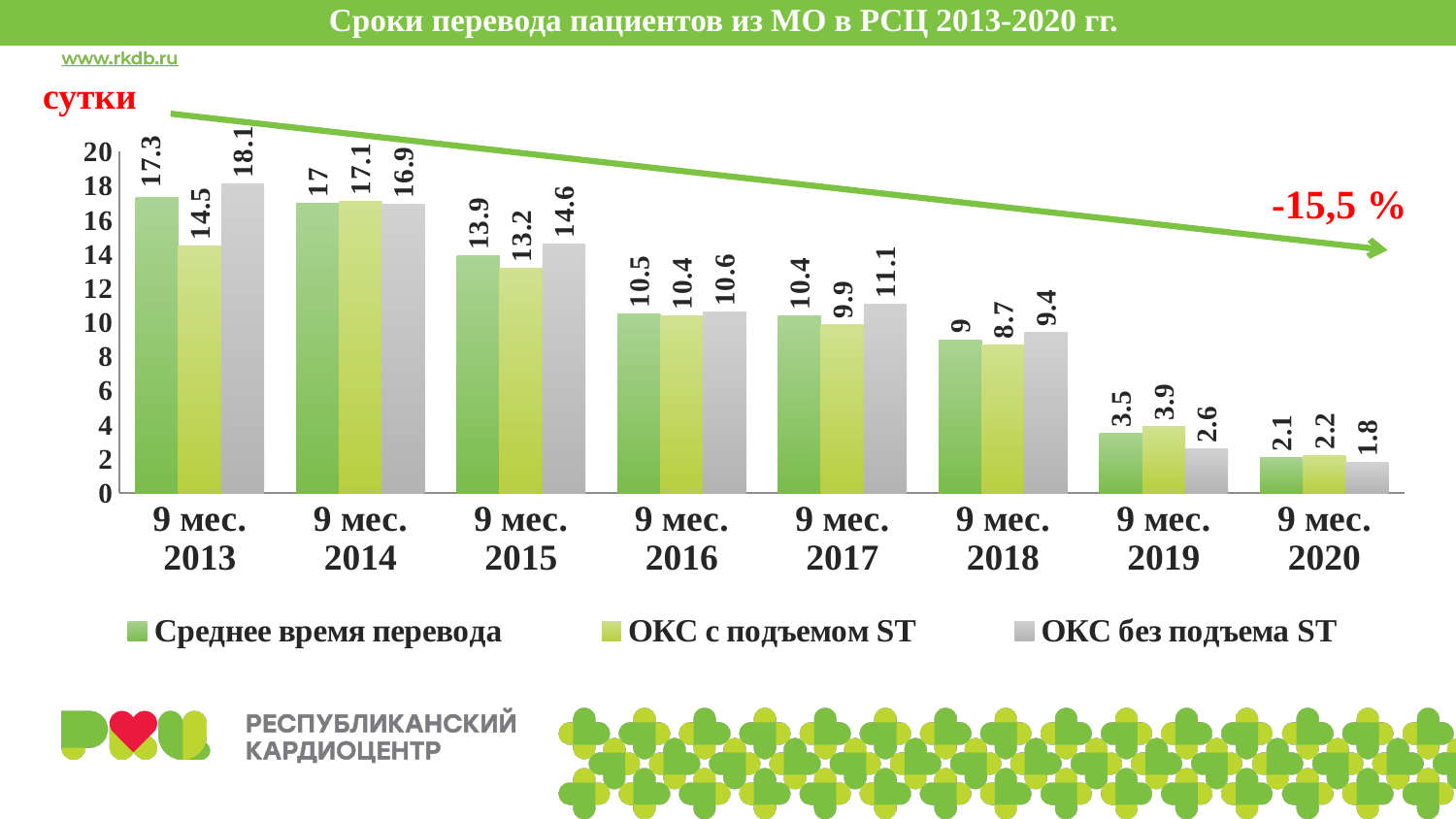
Do the values of "Среднее время перевода" rise or fall from 9 мес. 2013 to 9 мес. 2020? fall How many categories are shown on the x axis? 8 What is the value of "ОКС без подъема ST" for 9 мес. 2017? 11.1 What is the value of "ОКС с подъемом ST" for 9 мес. 2019? 3.9 What kind of chart is shown on the slide? bar chart What is the value of "Среднее время перевода" for 9 мес. 2013? 17.3 In which category is "ОКС без подъема ST" highest? 9 мес. 2013 What percentage change is printed in red next to the arrow on the chart? -15,5 % In which category is "Среднее время перевода" lowest? 9 мес. 2020 Which is larger for 9 мес. 2019: "ОКС с подъемом ST" or "ОКС без подъема ST"? ОКС с подъемом ST How many series does the legend list? 3 What is the difference between "ОКС без подъема ST" and "ОКС с подъемом ST" for 9 мес. 2013? 3.6